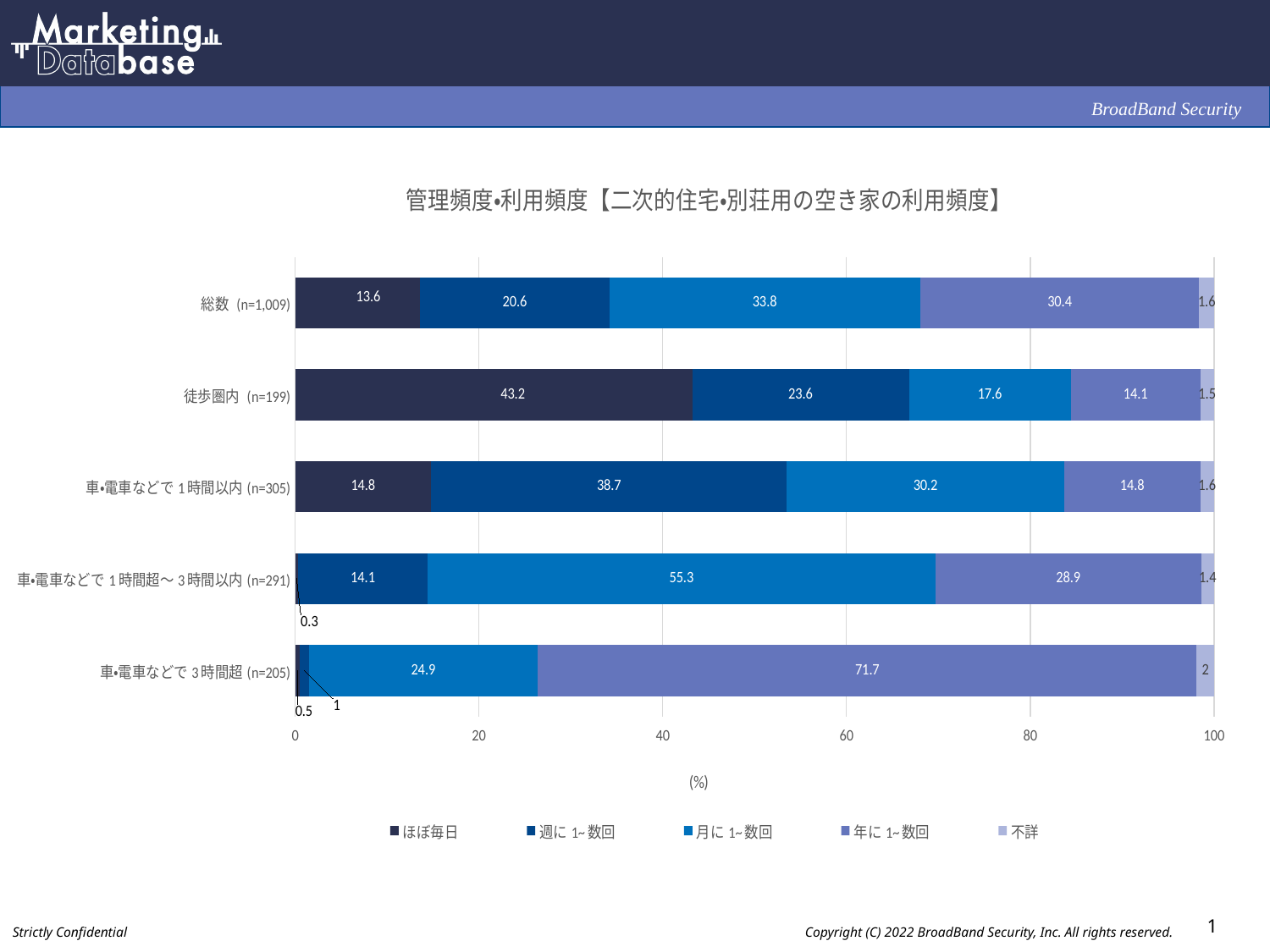
What type of chart is shown on the slide? Stacked horizontal bar chart Which category has the highest value for ほぼ毎日? 徒歩圏内 (n=199) Which category has the lowest value for 年に1～数回? 徒歩圏内 (n=199) What is the value of 年に1～数回 for 車・電車などで3時間超 (n=205)? 71.7 What is the title of the chart? 管理頻度・利用頻度【二次的住宅・別荘用の空き家の利用頻度】 How many series does the legend list? 5 Which is larger: the 週に1～数回 value for 総数 (n=1,009) or for 徒歩圏内 (n=199)? 徒歩圏内 (n=199) What is the value of 月に1～数回 for 総数 (n=1,009)? 33.8 What is the difference between the 月に1～数回 values for 車・電車などで1時間超～3時間以内 (n=291) and 車・電車などで3時間超 (n=205)? 30.4 What is the value of ほぼ毎日 for 徒歩圏内 (n=199)? 43.2 What is the value of 週に1～数回 for 車・電車などで1時間以内 (n=305)? 38.7 How many categories (rows) are plotted in the chart? 5